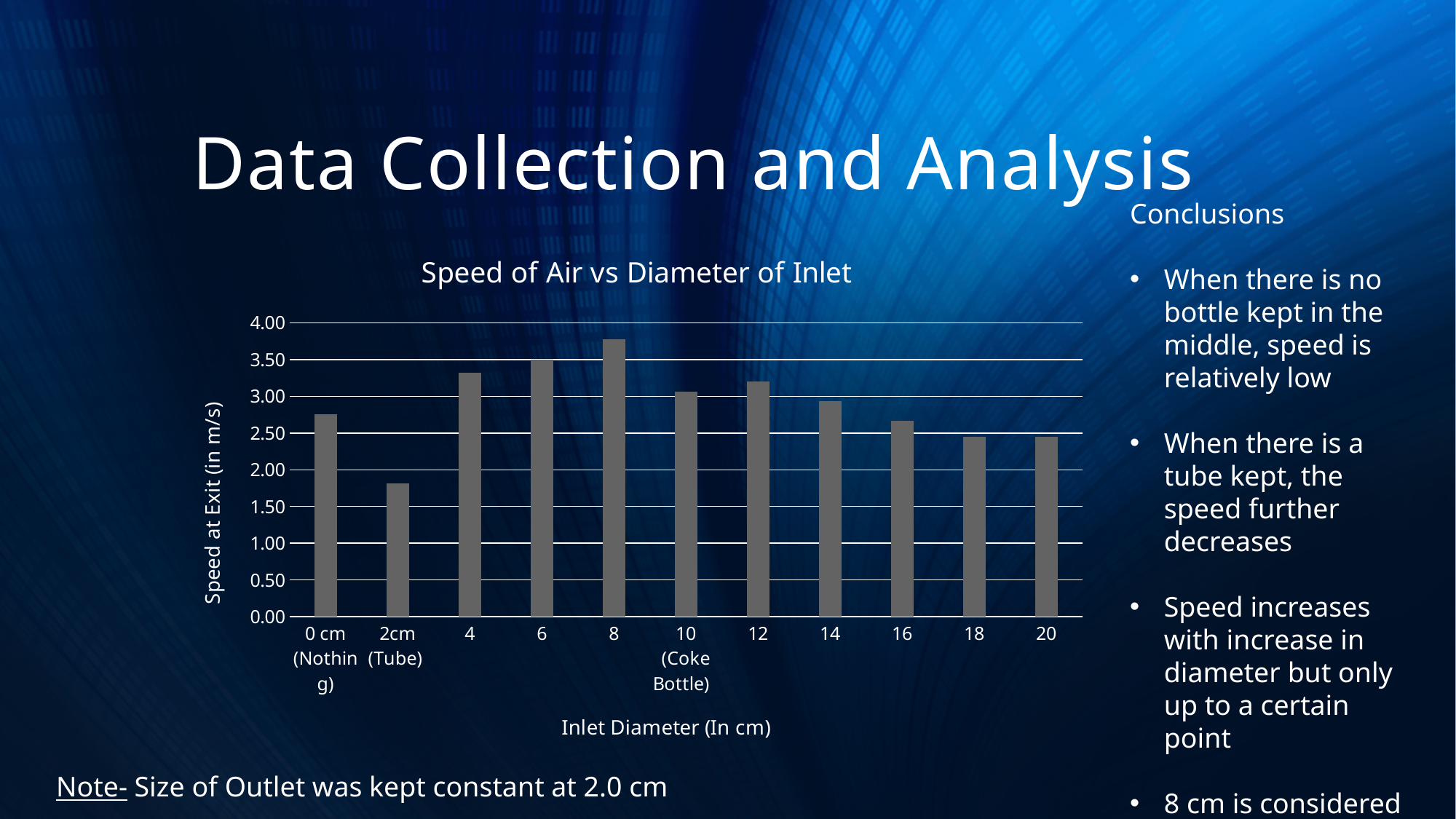
Which inlet diameter has the highest speed at exit? 8 What is the label of the vertical axis of the chart? Speed at Exit (in m/s) Is the speed at exit for an inlet diameter of 12 greater or less than 3.00? greater What kind of chart is shown on the slide? bar chart How many bars (inlet diameter categories) are plotted in the chart? 11 Is the speed at exit for the 0 cm (Nothing) category greater or less than 2.50? greater Which has a higher speed at exit: inlet diameter 4 or inlet diameter 6? 6 From inlet diameter 8 to inlet diameter 20, do the speeds at exit generally rise or fall? fall Is the speed at exit for the 2cm (Tube) category greater or less than 2.00? less What is the title of the chart? Speed of Air vs Diameter of Inlet Which category has the lowest speed at exit? 2cm (Tube)